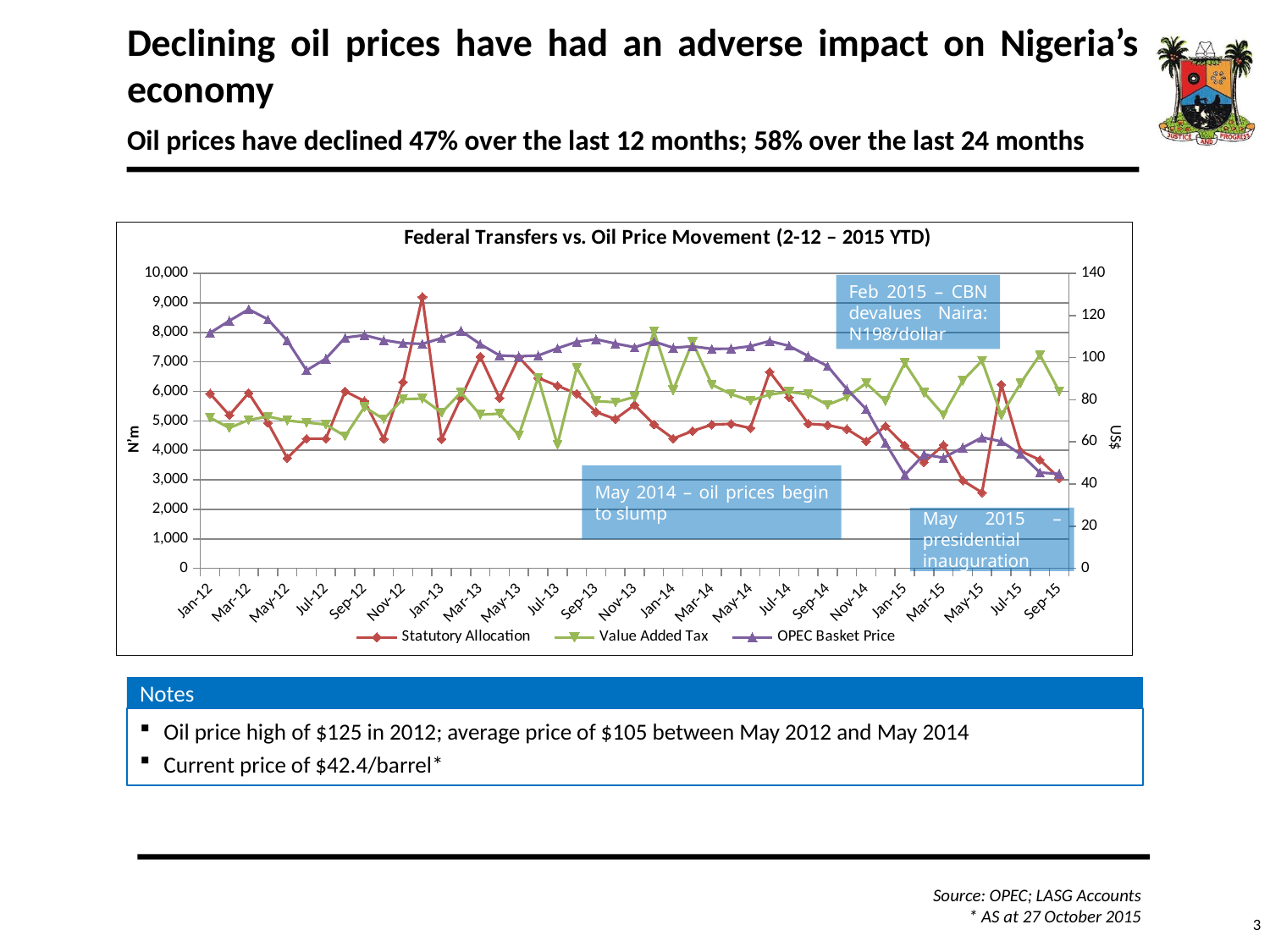
Is the Value Added Tax value for Jan-14 greater or less than 7,000? less What is the title of the chart? Federal Transfers vs. Oil Price Movement (2-12 – 2015 YTD) In which month does the Statutory Allocation series reach its lowest value? May-15 Is the Statutory Allocation value for Jan-13 greater or less than 8,000? less In which month does the OPEC Basket Price series reach its highest value? Mar-12 What kind of chart is shown on the slide? line chart Does the OPEC Basket Price rise or fall between Jul-14 and Jan-15? fall In which month does the Statutory Allocation series reach its highest value? Dec-12 How many series does the legend of the chart list? 3 Which series is plotted against the right-hand US$ axis? OPEC Basket Price Is the OPEC Basket Price value for Sep-15 greater or less than 60? less In Jan-14, which is larger: Statutory Allocation or Value Added Tax? Value Added Tax